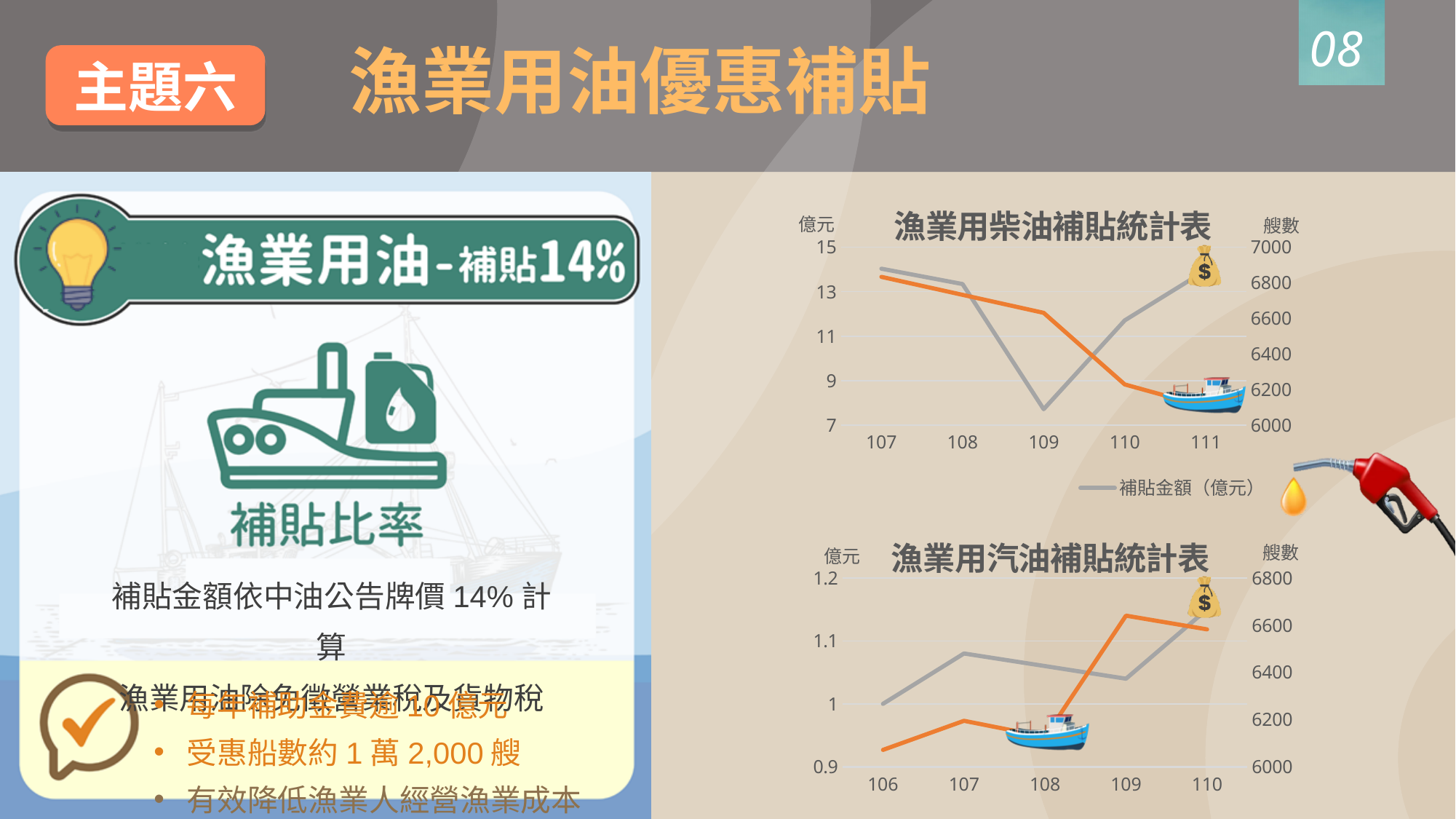
In the 漁業用汽油補貼統計表, is the gray 補貼金額 value for 106 greater or less than 1.1? less In the 漁業用汽油補貼統計表, how many years are shown on the x axis? 5 In the 漁業用汽油補貼統計表, is the orange line (艘數) value for 109 greater or less than 6400? greater In the 漁業用柴油補貼統計表, which is larger, the 補貼金額（億元） for 107 or for 109? 107 In the 漁業用柴油補貼統計表, is the 補貼金額（億元） for 107 greater or less than 13? greater In the 漁業用柴油補貼統計表, how many years are shown on the x axis? 5 What series name is shown in the legend of the 漁業用柴油補貼統計表? 補貼金額（億元） In the 漁業用柴油補貼統計表, which year has the lowest 補貼金額（億元）? 109 In the 漁業用柴油補貼統計表, does the orange line (艘數) rise or fall from 107 to 111? fall In the 漁業用汽油補貼統計表, which year has the highest value on the gray 補貼金額 line? 110 What kind of chart is the 漁業用柴油補貼統計表? line chart